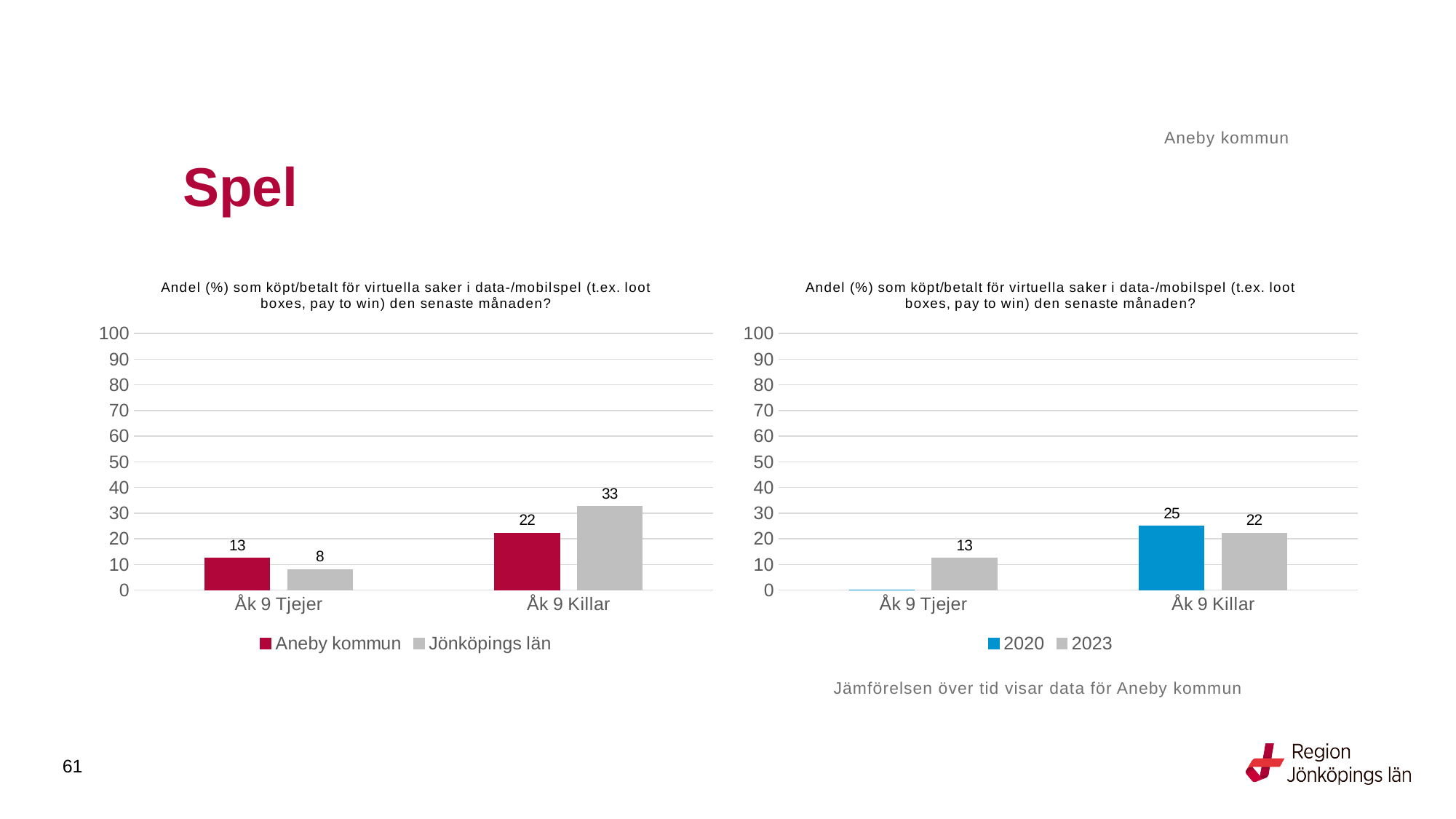
In the left chart, which is larger for Åk 9 Tjejer: Aneby kommun or Jönköpings län? Aneby kommun In the left chart, what is the value for Jönköpings län for Åk 9 Tjejer? 8 In the right chart, what is the value for 2020 for Åk 9 Killar? 25 In the left chart, what is the value for Aneby kommun for Åk 9 Tjejer? 13 In the right chart, is the value for 2023 for Åk 9 Killar greater or less than 30? less In the left chart, what is the difference between Jönköpings län and Aneby kommun for Åk 9 Killar? 11 In the right chart, what is the value for 2023 for Åk 9 Tjejer? 13 In the left chart, what is the value for Jönköpings län for Åk 9 Killar? 33 In the right chart, what is the difference between 2020 and 2023 for Åk 9 Killar? 3 How many series does the legend of the right chart list? 2 In the left chart, which bar has the highest value? Jönköpings län, Åk 9 Killar What kind of chart is the left chart? bar chart